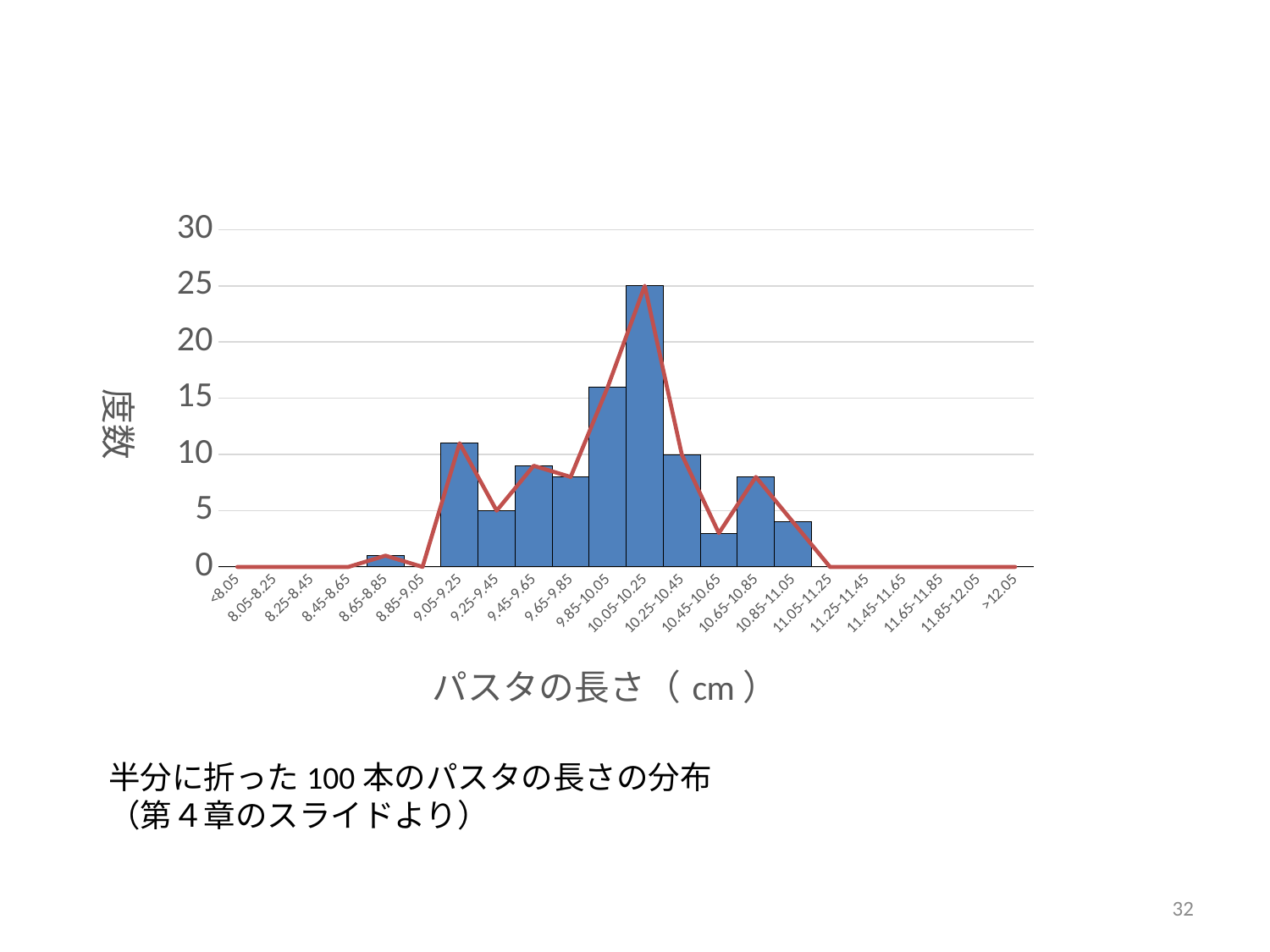
What is the frequency for the 9.25-9.45 bin? 5 What is the difference between the frequencies of the 10.05-10.25 bin and the 10.25-10.45 bin? 15 What is the frequency for the 10.05-10.25 bin? 25 How many length bins are shown on the x axis? 22 What is the frequency for the 10.25-10.45 bin? 10 Is the frequency for the 10.45-10.65 bin greater or less than 5? less What kind of chart is shown on the slide? bar chart (histogram) with a line overlay Is the frequency for the 9.85-10.05 bin greater or less than 15? greater What is the label of the vertical axis? 度数 Which bin has the larger frequency, 9.05-9.25 or 9.25-9.45? 9.05-9.25 Which length bin has the highest frequency? 10.05-10.25 What is the frequency for the <8.05 bin? 0